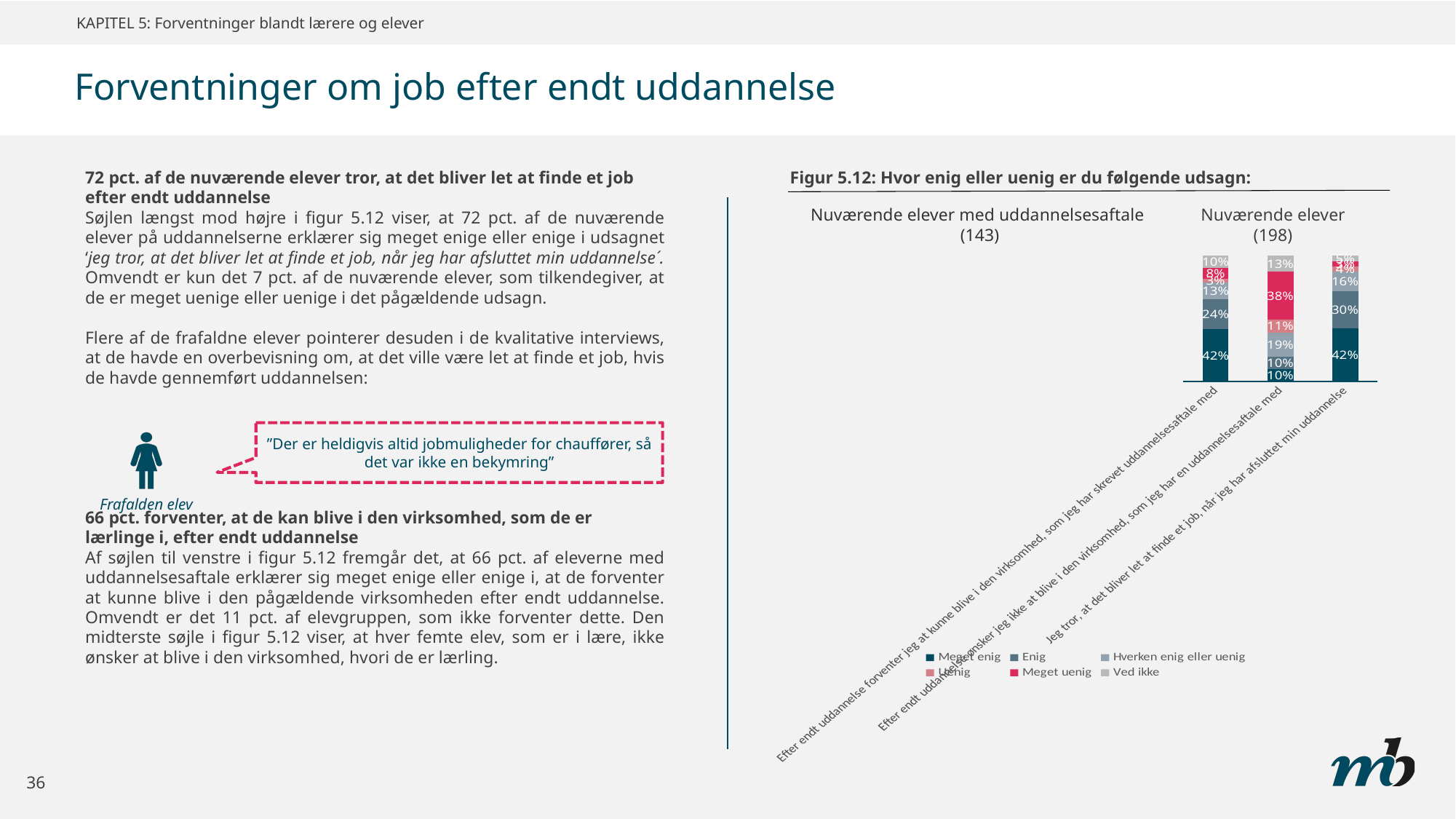
In Figur 5.12, what share answered 'Enig' to the statement 'Jeg tror, at det bliver let at finde et job, når jeg har afsluttet min uddannelse'? 30% In Figur 5.12, how many percentage points higher is the 'Enig' share for the right-hand bar (let at finde et job) than for the left-hand bar (forventer at kunne blive i virksomheden)? 6 percentage points How many series does the legend of Figur 5.12 list? 6 In Figur 5.12, which bar has the larger 'Meget uenig' share: the left-hand bar (forventer at kunne blive i virksomheden) or the middle bar (ønsker ikke at blive i virksomheden)? The middle bar (ønsker ikke at blive i virksomheden) In Figur 5.12, what share answered 'Meget enig' to the statement 'Jeg tror, at det bliver let at finde et job, når jeg har afsluttet min uddannelse'? 42% In Figur 5.12, what share answered 'Enig' to the statement 'Efter endt uddannelse forventer jeg at kunne blive i den virksomhed, som jeg har skrevet uddannelsesaftale med'? 24% In Figur 5.12, how many respondents are in the group 'Nuværende elever' shown above the right-hand bar? 198 In Figur 5.12, what share answered 'Meget uenig' to the statement 'Efter endt uddannelse ønsker jeg ikke at blive i den virksomhed, som jeg har en uddannelsesaftale med'? 38% How many bars are plotted in Figur 5.12? 3 In Figur 5.12, what share answered 'Hverken enig eller uenig' to the middle statement 'Efter endt uddannelse ønsker jeg ikke at blive i den virksomhed, som jeg har en uddannelsesaftale med'? 19% What kind of chart is Figur 5.12? Stacked bar chart In Figur 5.12, which statement has the highest 'Meget uenig' share? Efter endt uddannelse ønsker jeg ikke at blive i den virksomhed, som jeg har en uddannelsesaftale med